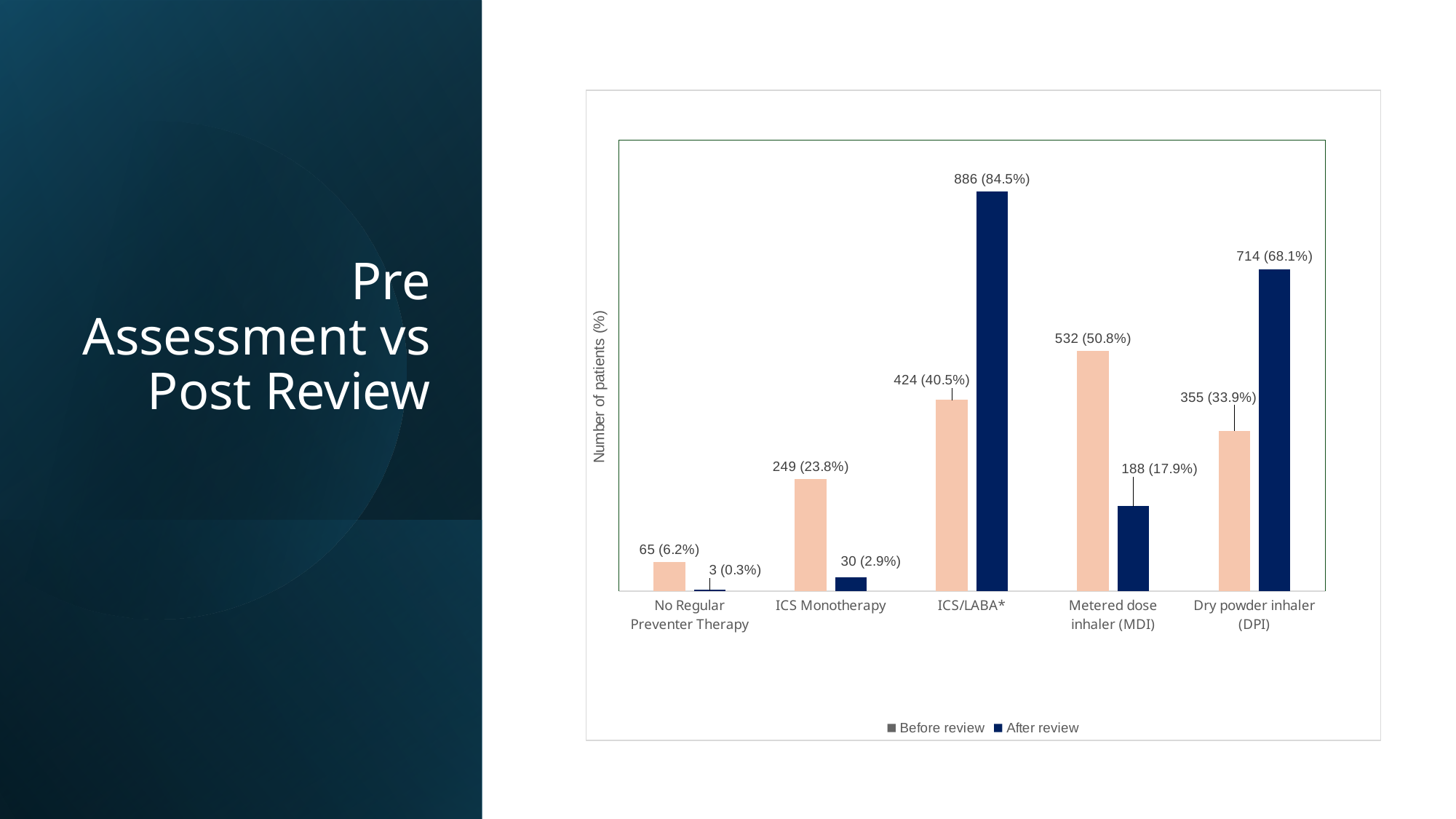
How many categories are shown on the x axis? 5 How many series does the legend list? 2 Which category has the lowest 'Before review' value? No Regular Preventer Therapy What is the 'Before review' value for ICS Monotherapy? 249 (23.8%) What is the difference in the number of patients between 'After review' and 'Before review' for Dry powder inhaler (DPI)? 359 Which is larger for Metered dose inhaler (MDI): the 'Before review' value or the 'After review' value? Before review What kind of chart is shown on the slide? Bar chart What is the 'Before review' value for Metered dose inhaler (MDI)? 532 (50.8%) Which category has the highest 'After review' value? ICS/LABA* What is the label of the vertical axis? Number of patients (%) What is the 'After review' value for ICS/LABA*? 886 (84.5%) What is the 'After review' value for No Regular Preventer Therapy? 3 (0.3%)